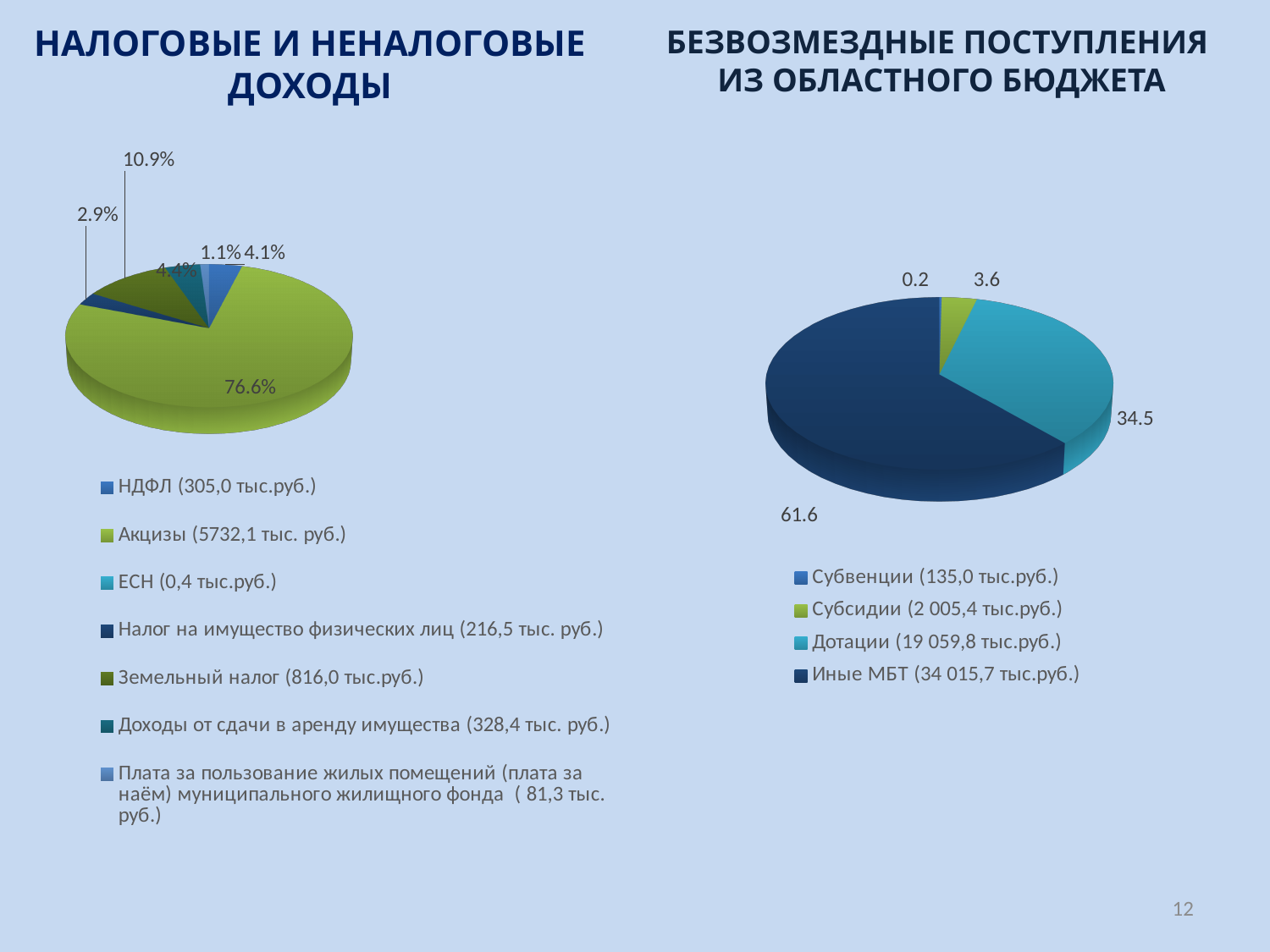
In the right chart «БЕЗВОЗМЕЗДНЫЕ ПОСТУПЛЕНИЯ ИЗ ОБЛАСТНОГО БЮДЖЕТА», what is the value shown for the largest slice (Иные МБТ)? 61.6 In the right chart «БЕЗВОЗМЕЗДНЫЕ ПОСТУПЛЕНИЯ ИЗ ОБЛАСТНОГО БЮДЖЕТА», how many entries does the legend list? 4 In the left chart «НАЛОГОВЫЕ И НЕНАЛОГОВЫЕ ДОХОДЫ», what is the share of the largest slice? 76.6% In the right chart «БЕЗВОЗМЕЗДНЫЕ ПОСТУПЛЕНИЯ ИЗ ОБЛАСТНОГО БЮДЖЕТА», what is the difference between the values for Иные МБТ and Дотации? 27.1 In the right chart «БЕЗВОЗМЕЗДНЫЕ ПОСТУПЛЕНИЯ ИЗ ОБЛАСТНОГО БЮДЖЕТА», what is the value shown for Дотации? 34.5 In the right chart «БЕЗВОЗМЕЗДНЫЕ ПОСТУПЛЕНИЯ ИЗ ОБЛАСТНОГО БЮДЖЕТА», which is larger: Дотации or Субсидии? Дотации In the left chart «НАЛОГОВЫЕ И НЕНАЛОГОВЫЕ ДОХОДЫ», how many entries does the legend list? 7 In the right chart «БЕЗВОЗМЕЗДНЫЕ ПОСТУПЛЕНИЯ ИЗ ОБЛАСТНОГО БЮДЖЕТА», which category has the smallest slice? Субвенции (135,0 тыс.руб.) What kind of chart is the right chart titled «БЕЗВОЗМЕЗДНЫЕ ПОСТУПЛЕНИЯ ИЗ ОБЛАСТНОГО БЮДЖЕТА»? Pie chart In the right chart «БЕЗВОЗМЕЗДНЫЕ ПОСТУПЛЕНИЯ ИЗ ОБЛАСТНОГО БЮДЖЕТА», what is the value shown for Субсидии? 3.6 In the left chart «НАЛОГОВЫЕ И НЕНАЛОГОВЫЕ ДОХОДЫ», which legend category corresponds to the largest slice? Акцизы (5732,1 тыс. руб.) What kind of chart is the left chart titled «НАЛОГОВЫЕ И НЕНАЛОГОВЫЕ ДОХОДЫ»? Pie chart